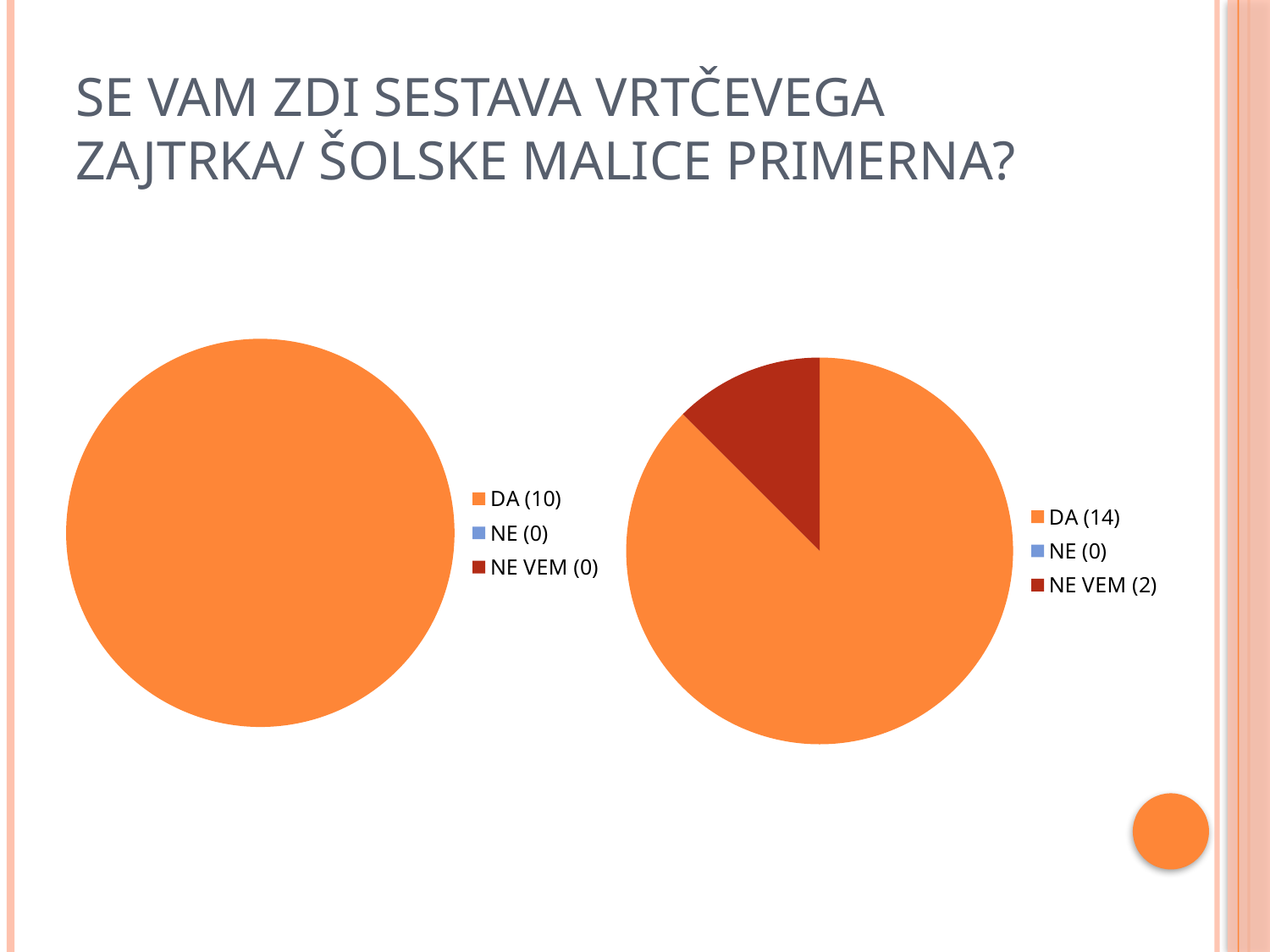
In the left pie chart, which category has the highest value? DA In the right pie chart, which category has the highest value? DA What type of chart is shown on the left of the slide? pie chart How many categories does the legend of the right pie chart list? 3 In the right pie chart, what is the difference between DA and NE VEM? 12 What is the value for NE in the left pie chart? 0 In the right pie chart, what share of the total does NE VEM represent? 12.5% In the left pie chart, what is the value for DA? 10 In the right pie chart, what is the value for DA? 14 What is the total of all values in the right pie chart? 16 In the right pie chart, what is the value for NE VEM? 2 Which is larger in the right pie chart, DA or NE VEM? DA